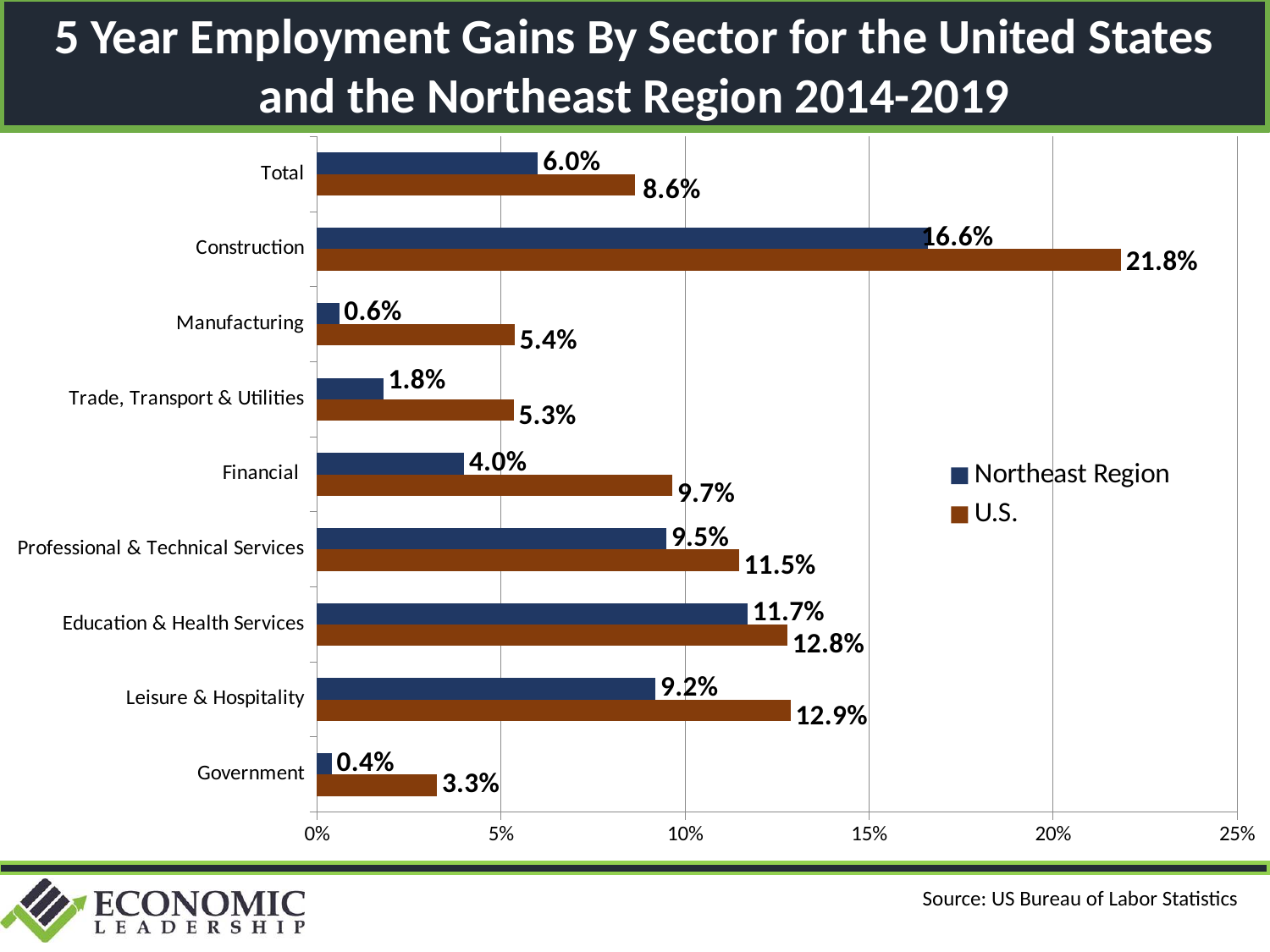
How many sector categories are shown on the chart, including Total? 9 What is the difference between the U.S. and Northeast Region values for Financial? 5.7% How many series does the legend list? 2 Is the Northeast Region value for Construction greater or less than 15%? greater What is the U.S. employment gain for Construction? 21.8% Which sector has the lowest Northeast Region employment gain? Government Which is larger for Manufacturing: the Northeast Region value or the U.S. value? U.S. What kind of chart is shown on the slide? Bar chart What is the Northeast Region employment gain for Financial? 4.0% Which sector has the highest U.S. employment gain? Construction What is the Northeast Region value for Government? 0.4% What is the source cited for the chart data? US Bureau of Labor Statistics